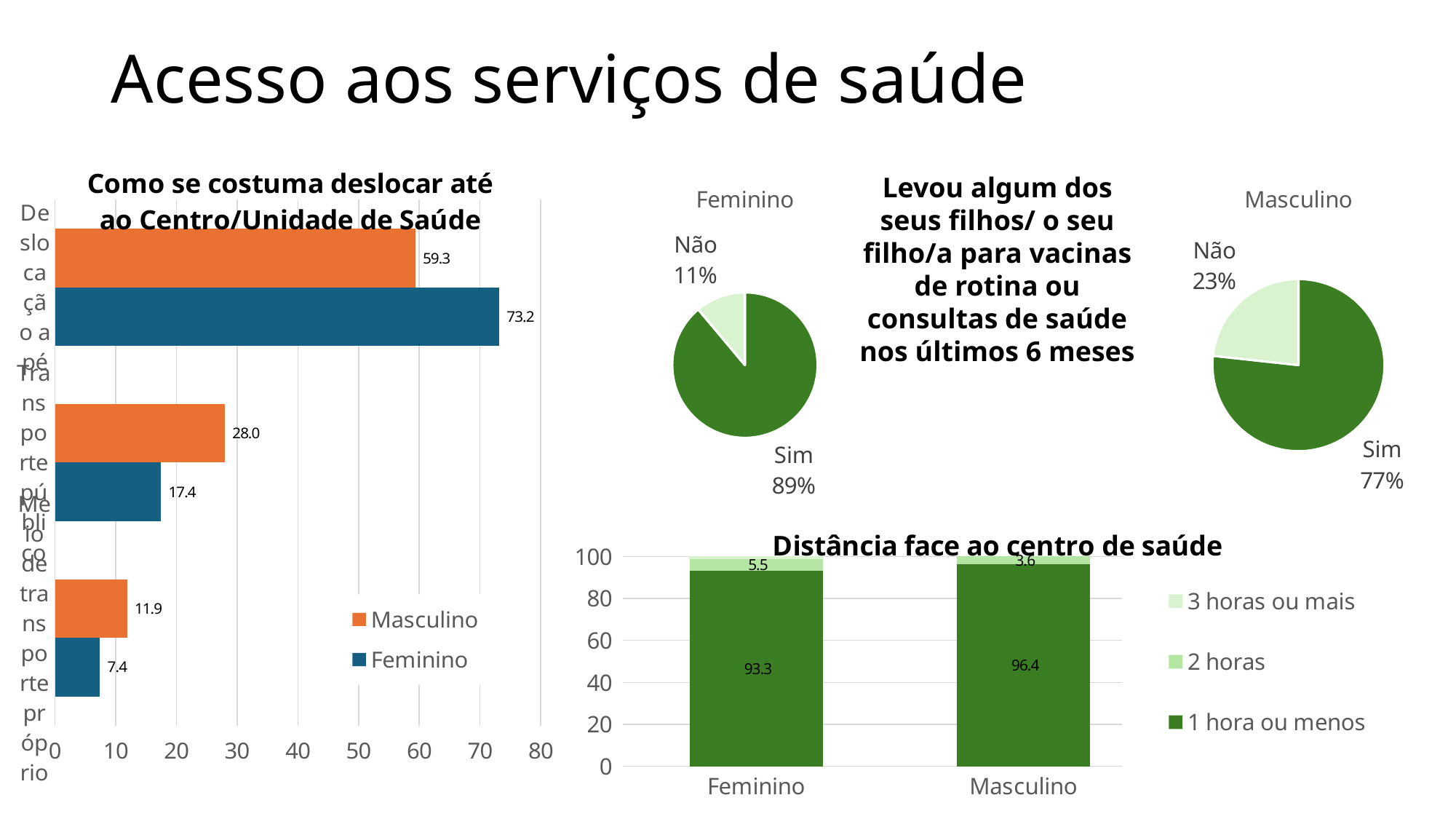
In the chart 'Como se costuma deslocar até ao Centro/Unidade de Saúde', which category has the highest Feminino value? Deslocação a pé In the chart 'Distância face ao centro de saúde', what is the value of '2 horas' for Feminino? 5.5 How many series does the legend of the chart 'Como se costuma deslocar até ao Centro/Unidade de Saúde' list? 2 In the chart 'Como se costuma deslocar até ao Centro/Unidade de Saúde', what is the value for Feminino for 'Deslocação a pé'? 73.2 In the chart 'Distância face ao centro de saúde', what is the value of '1 hora ou menos' for Masculino? 96.4 What kind of chart is 'Como se costuma deslocar até ao Centro/Unidade de Saúde'? Bar chart How many series does the legend of the chart 'Distância face ao centro de saúde' list? 3 In the Feminino pie chart, what share of respondents answered 'Sim'? 89% In the Masculino pie chart, what share of respondents answered 'Não'? 23% In the chart 'Como se costuma deslocar até ao Centro/Unidade de Saúde', what is the value for Masculino for 'Transporte público'? 28.0 In the chart 'Como se costuma deslocar até ao Centro/Unidade de Saúde', which series has the larger value for 'Transporte público', Masculino or Feminino? Masculino In the chart 'Como se costuma deslocar até ao Centro/Unidade de Saúde', what is the difference between the Masculino and Feminino values for 'Deslocação a pé'? 13.9